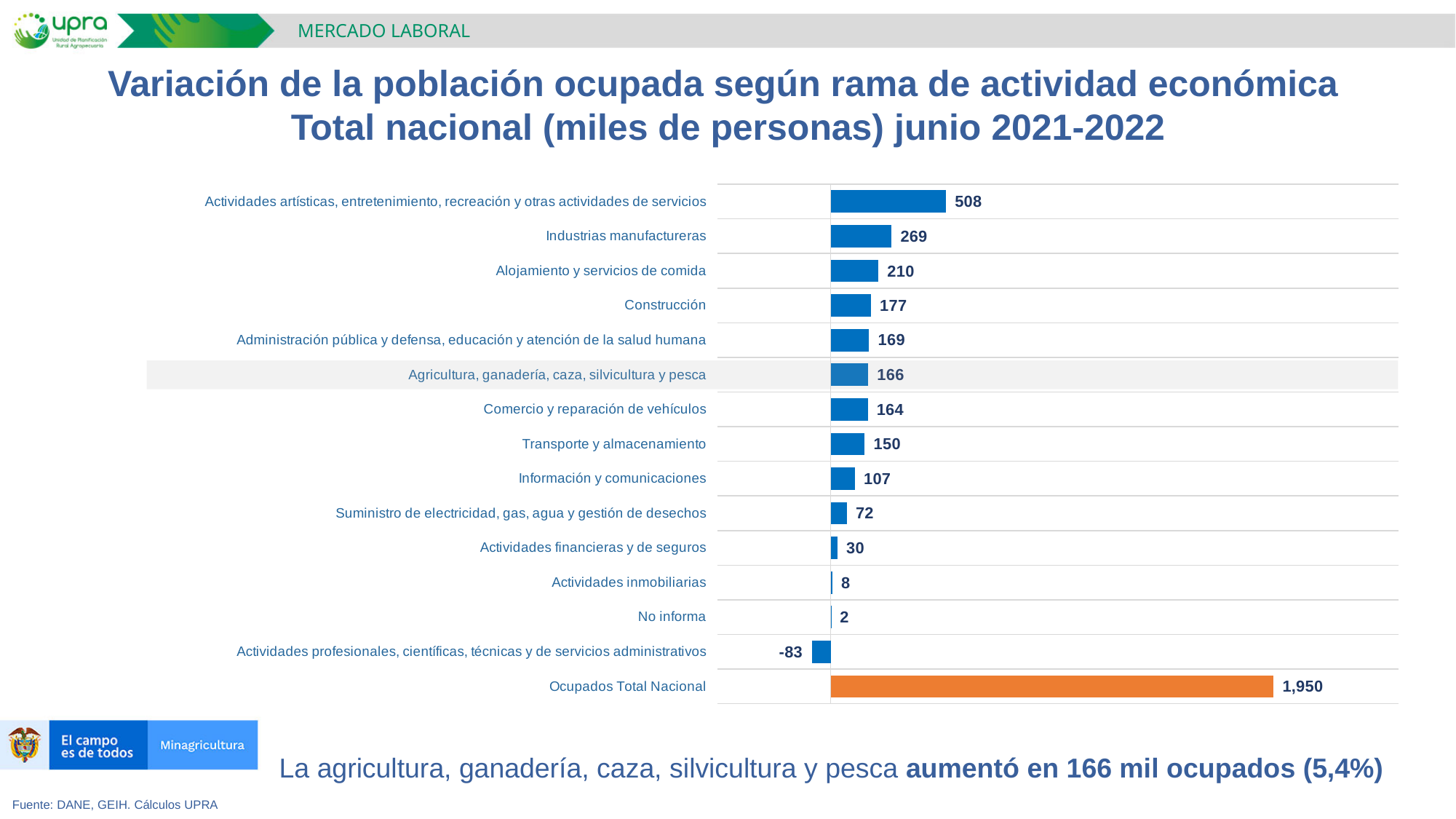
What is the difference between the values for Actividades artísticas, entretenimiento, recreación y otras actividades de servicios and Industrias manufactureras? 239 What is the difference between the values for Alojamiento y servicios de comida and Información y comunicaciones? 103 What is the value for Agricultura, ganadería, caza, silvicultura y pesca? 166 How many categories are shown in the chart? 15 What is the value for Ocupados Total Nacional? 1,950 What kind of chart is shown on the slide? Bar chart What is the value for Industrias manufactureras? 269 Which category has the lowest value? Actividades profesionales, científicas, técnicas y de servicios administrativos Which rama de actividad (excluding the national total) has the highest value? Actividades artísticas, entretenimiento, recreación y otras actividades de servicios Which bar is shown in orange rather than blue? Ocupados Total Nacional What is the value for Actividades profesionales, científicas, técnicas y de servicios administrativos? -83 Which is larger, the value for Construcción or the value for Transporte y almacenamiento? Construcción